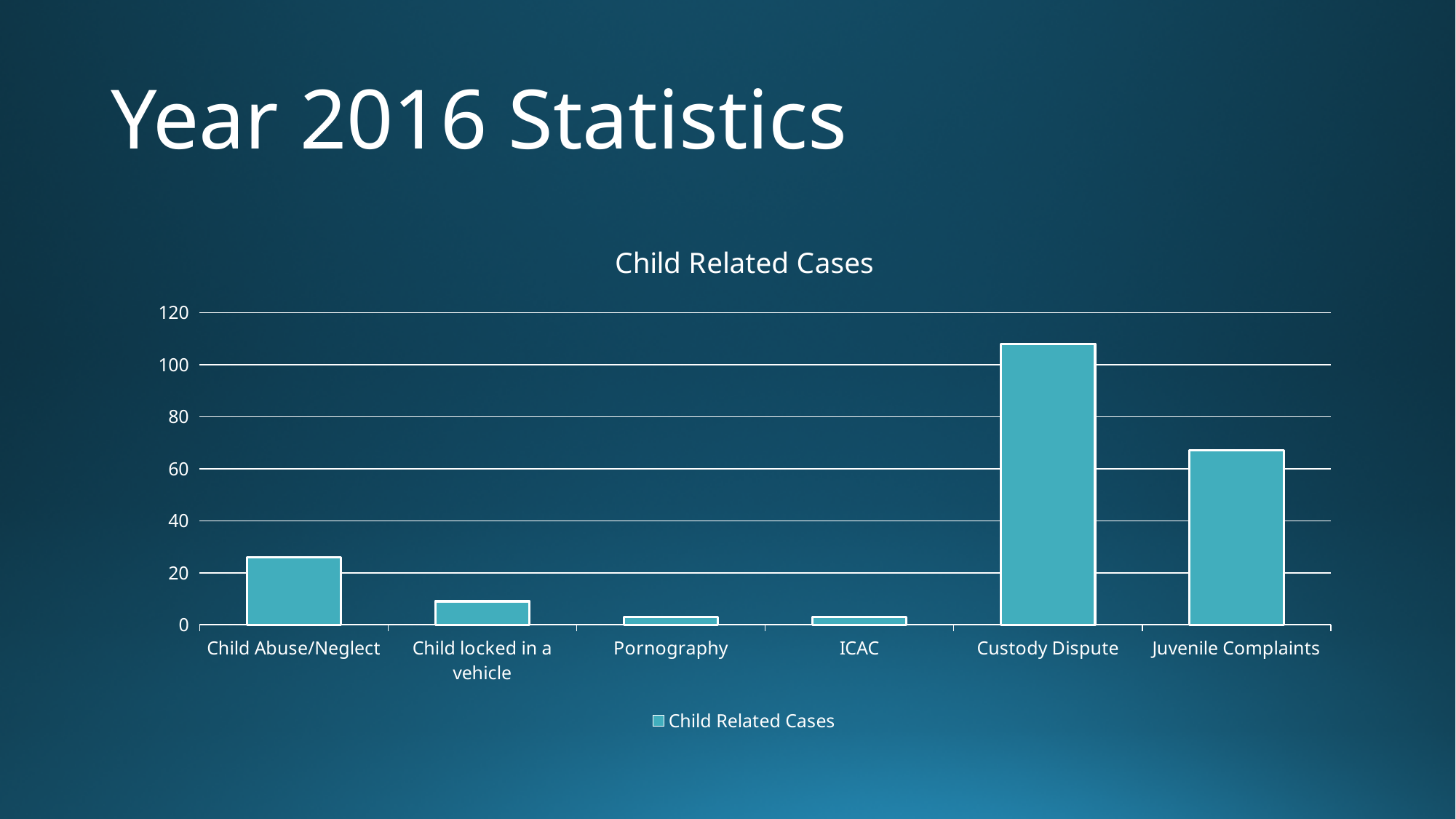
Is the value for Juvenile Complaints greater or less than 80? less What is the name of the series shown in the legend? Child Related Cases Is the value for Child locked in a vehicle greater or less than 20? less How many series does the legend list? 1 Which is larger, the value for Juvenile Complaints or the value for Child Abuse/Neglect? Juvenile Complaints Which category has the highest value? Custody Dispute Which is larger, the value for Child locked in a vehicle or the value for Pornography? Child locked in a vehicle Is the value for Child Abuse/Neglect greater or less than 20? greater What type of chart is shown on the slide? bar chart How many categories are shown on the x axis of the chart? 6 What is the title of the chart? Child Related Cases